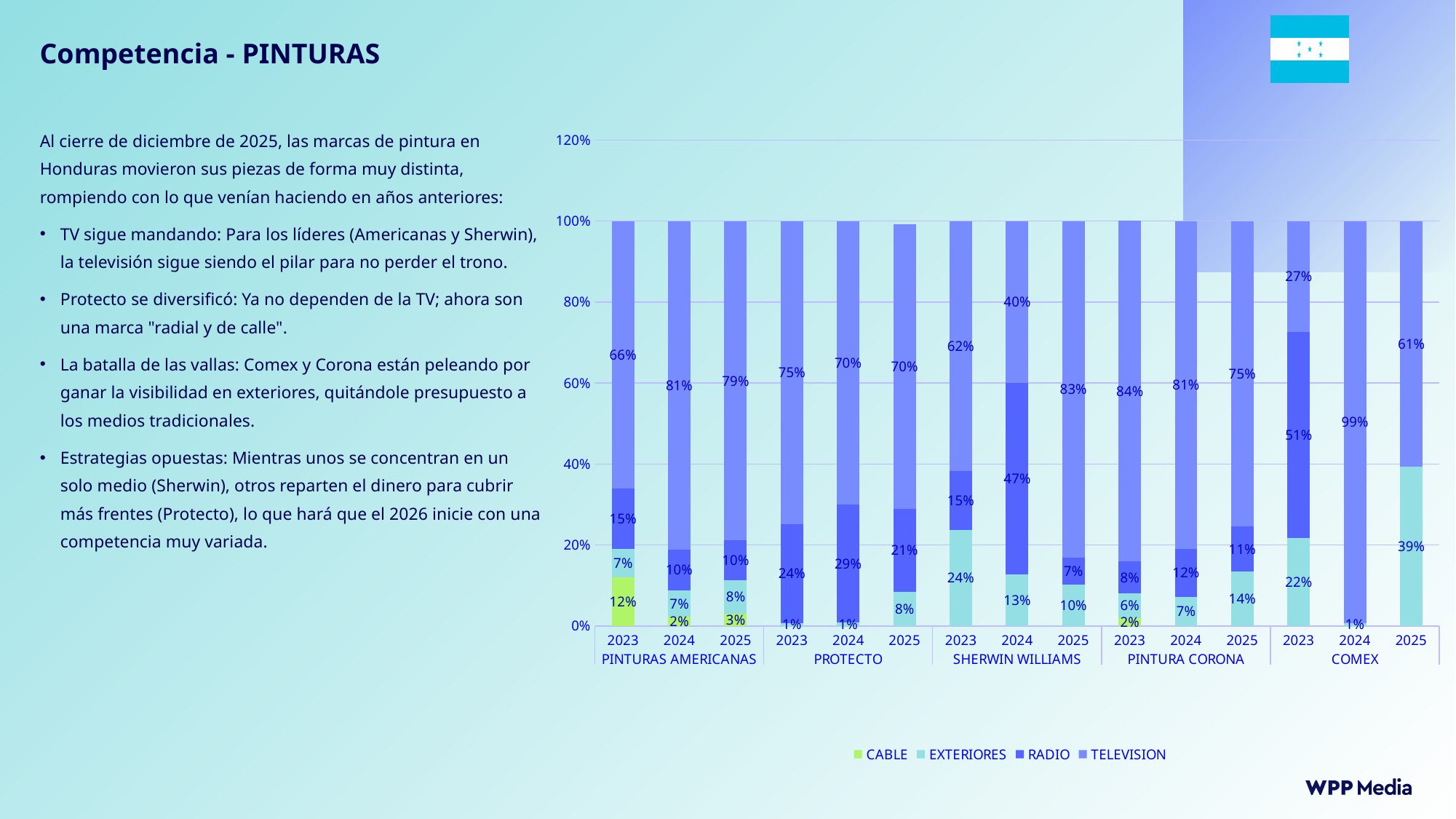
What is the EXTERIORES share for Comex in 2025? 39% How many bars (brand-year combinations) are plotted in the chart? 15 What is the RADIO share for Sherwin Williams in 2024? 47% How many series does the legend list? 4 What is the CABLE share for Pinturas Americanas in 2023? 12% Which brand and year has the lowest TELEVISION share? COMEX 2023 (27%) What kind of chart is shown on the slide? Stacked bar chart What is the difference between the RADIO share of Protecto in 2024 and in 2025? 8 percentage points Which brand and year has the highest TELEVISION share? COMEX 2024 (99%) What percentage of Pinturas Americanas' 2023 mix was TELEVISION? 66% Does the EXTERIORES share for Pintura Corona rise or fall from 2023 to 2025? Rises Which is larger: the EXTERIORES share of Sherwin Williams in 2023 or of Comex in 2023? Sherwin Williams 2023 (24%)